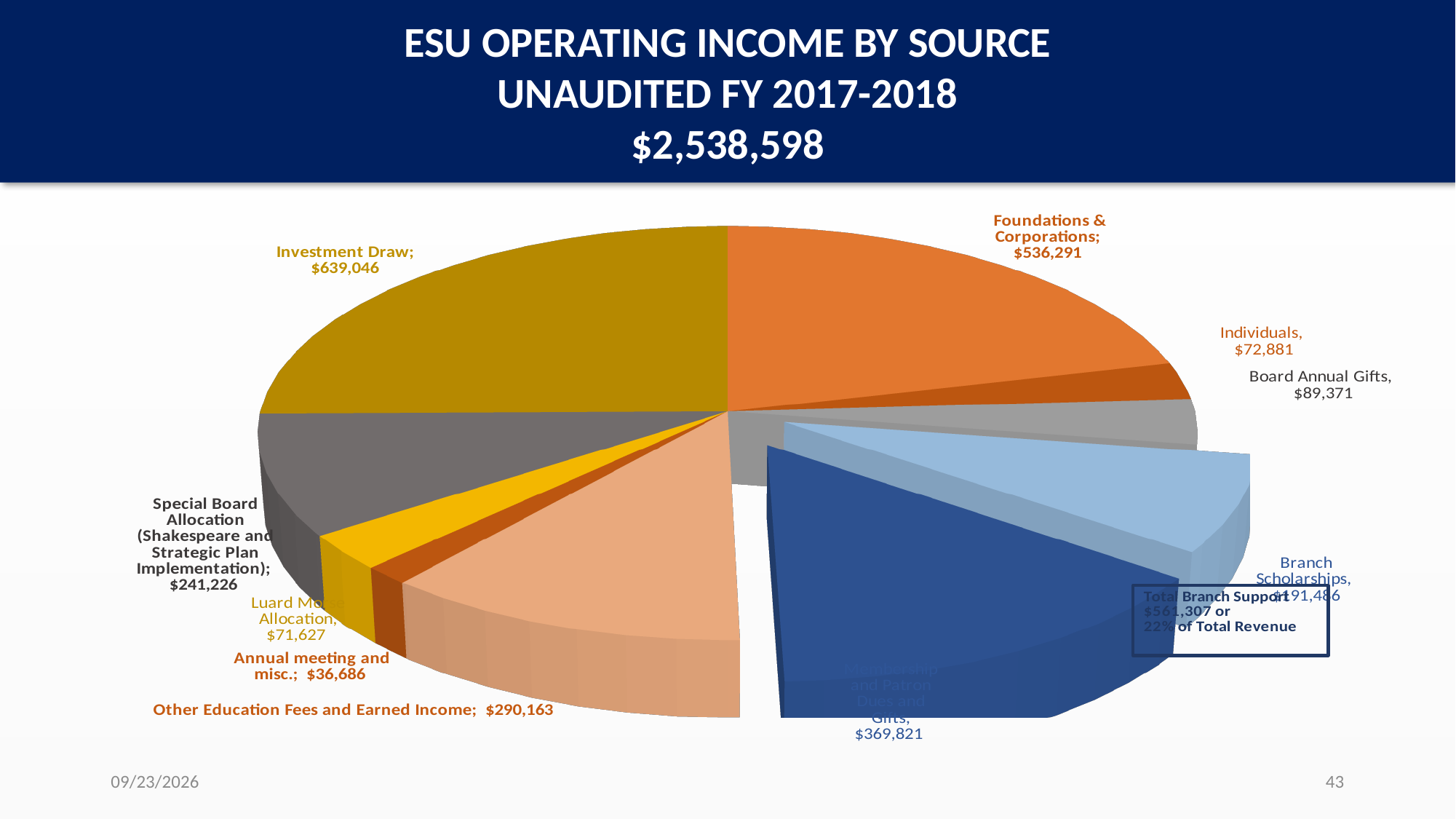
What is the difference between Board Annual Gifts and Individuals? $16,490 What is the difference between Investment Draw and Foundations & Corporations? $102,755 What is the value for Other Education Fees and Earned Income? $290,163 What kind of chart is shown on the slide? Pie chart What is the value for Investment Draw? $639,046 What is the value for Foundations & Corporations? $536,291 How many income sources are shown in the pie chart? 10 According to the text box, what share of total revenue is Total Branch Support? 22% Which is larger, Foundations & Corporations or Membership and Patron Dues and Gifts? Foundations & Corporations Which income source is the smallest slice of the pie? Annual meeting and misc. Which income source is the largest slice of the pie? Investment Draw What is the value for Board Annual Gifts? $89,371